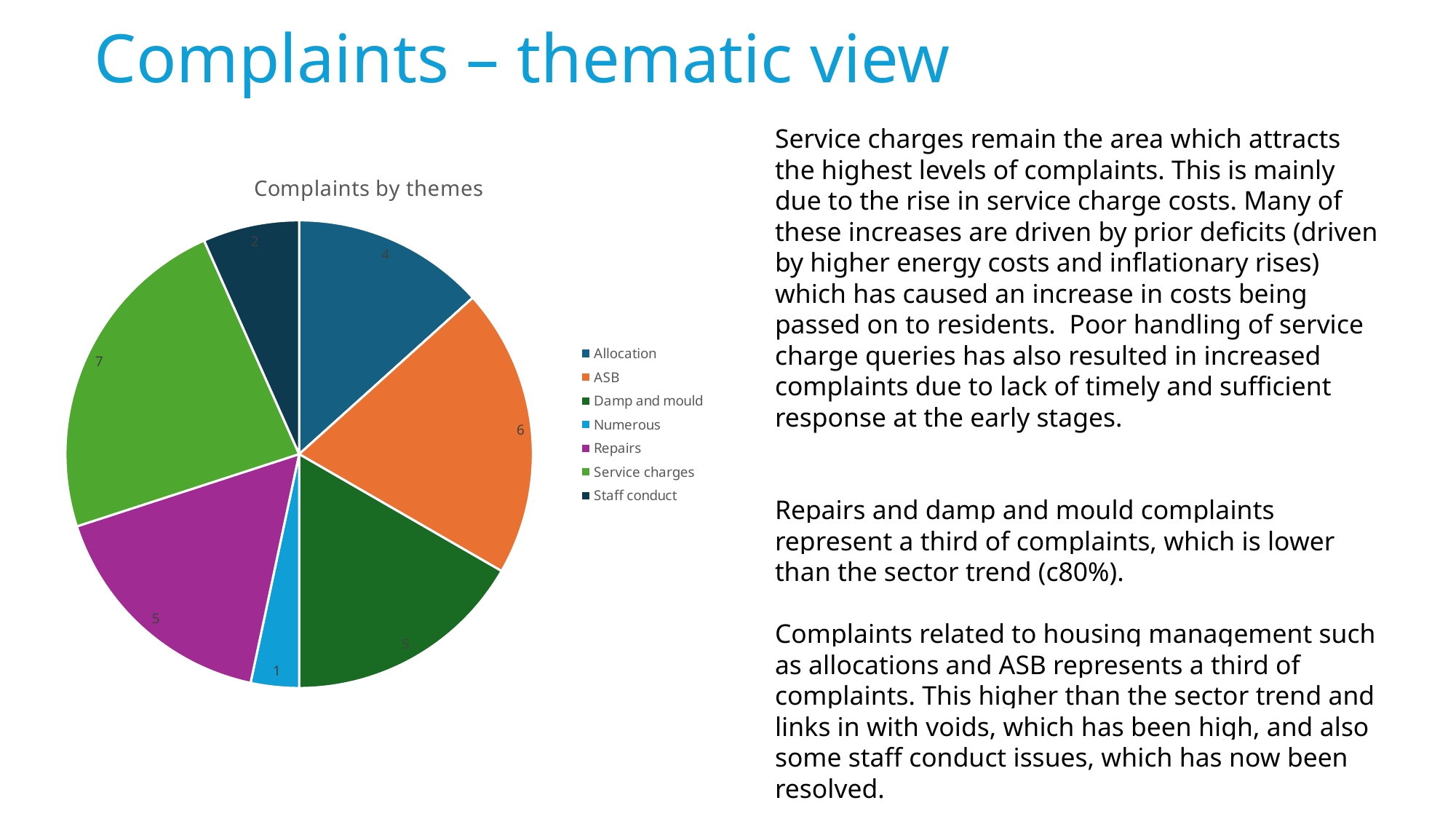
What is the value for Allocation? 4 What is the value for ASB? 6 What is the difference between the values for Service charges and Allocation? 3 How many themes (slices) are shown in the pie chart? 7 Which theme has the highest number of complaints? Service charges Which theme has the lowest number of complaints? Numerous How many complaints are shown for Service charges? 7 What is the total number of complaints across all slices of the pie? 30 Which has more complaints, ASB or Repairs? ASB What type of chart is shown on the slide? Pie chart What is the value for Staff conduct? 2 What is the title of the chart? Complaints by themes